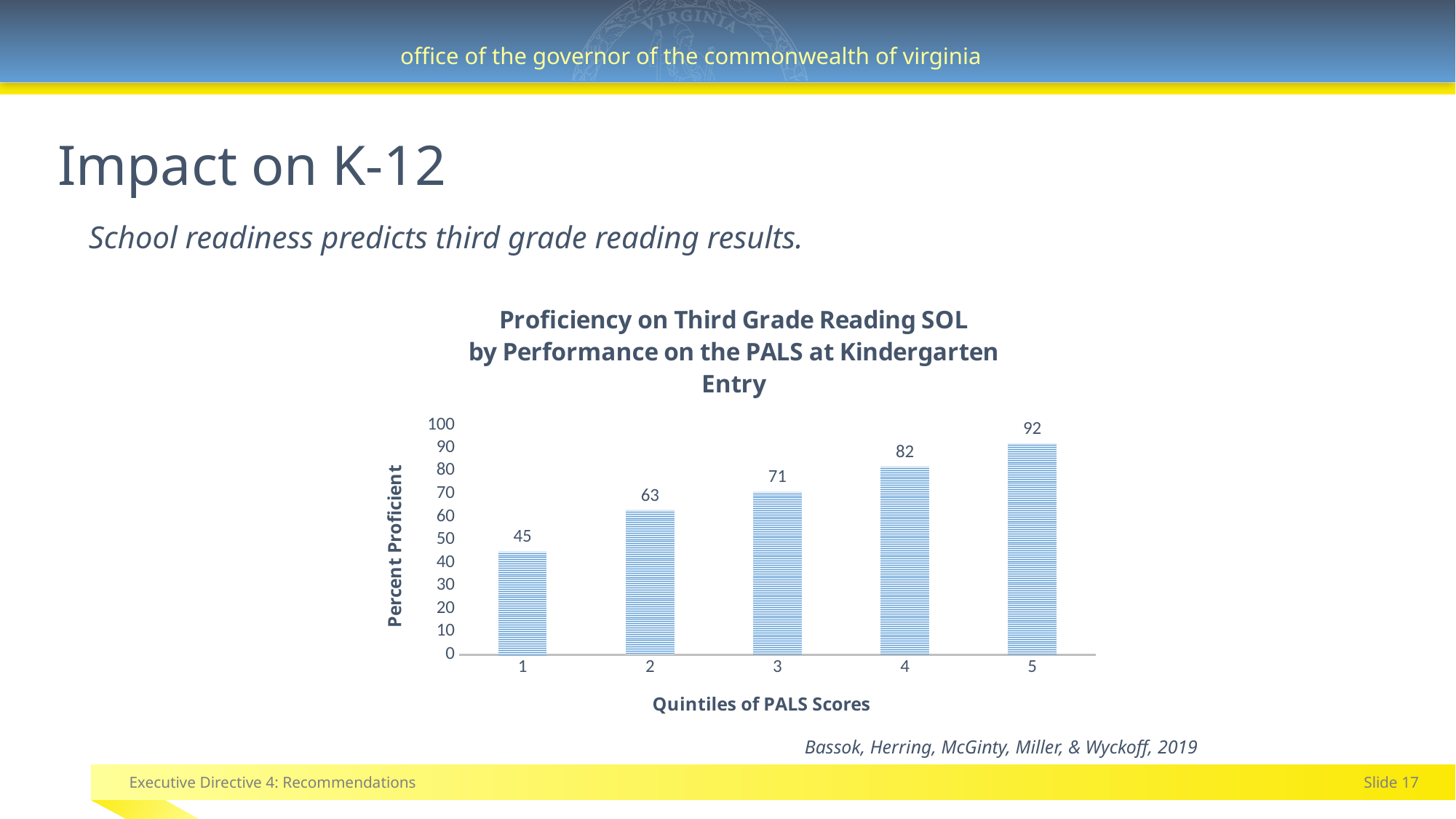
What is the percent proficient for quintile 5? 92 Which quintile has the highest percent proficient? 5 What is the percent proficient for quintile 1? 45 Do the values rise or fall as the quintile increases from 1 to 5? Rise What is the percent proficient for quintile 3? 71 What kind of chart is shown on the slide? Bar chart Which quintile has the lowest percent proficient? 1 Which has a higher percent proficient, quintile 2 or quintile 4? Quintile 4 What is the difference in percent proficient between quintile 4 and quintile 2? 19 How many quintiles are shown on the x axis? 5 Is the value for quintile 2 greater or less than 50? greater What is the difference in percent proficient between quintile 5 and quintile 1? 47